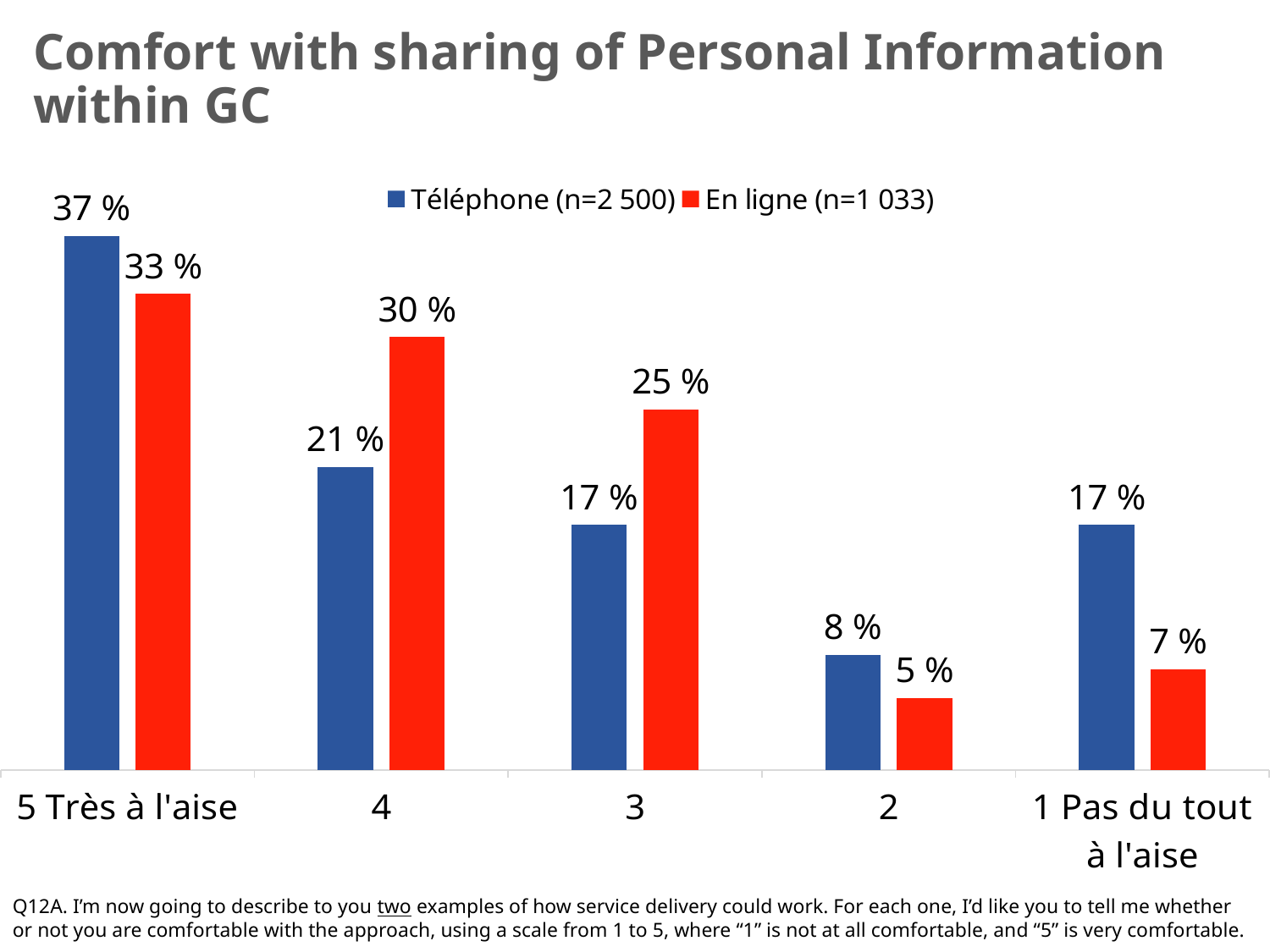
What is the Téléphone (n=2 500) value for the category "5 Très à l'aise"? 37 % What is the Téléphone (n=2 500) value for category "1 Pas du tout à l'aise"? 17 % Which category has the lowest Téléphone (n=2 500) value? 2 What kind of chart is shown on the slide? Bar chart How many series does the legend list? 2 For category 2, which series has the larger value, Téléphone (n=2 500) or En ligne (n=1 033)? Téléphone (n=2 500) Which colour represents the En ligne (n=1 033) series? Red What is the difference between the Téléphone (n=2 500) values for "5 Très à l'aise" and "1 Pas du tout à l'aise"? 20 % What is the difference between the Téléphone (n=2 500) and En ligne (n=1 033) values for category 3? 8 % What is the En ligne (n=1 033) value for category 4? 30 % How many categories are shown on the x axis? 5 Which category has the highest En ligne (n=1 033) value? 5 Très à l'aise